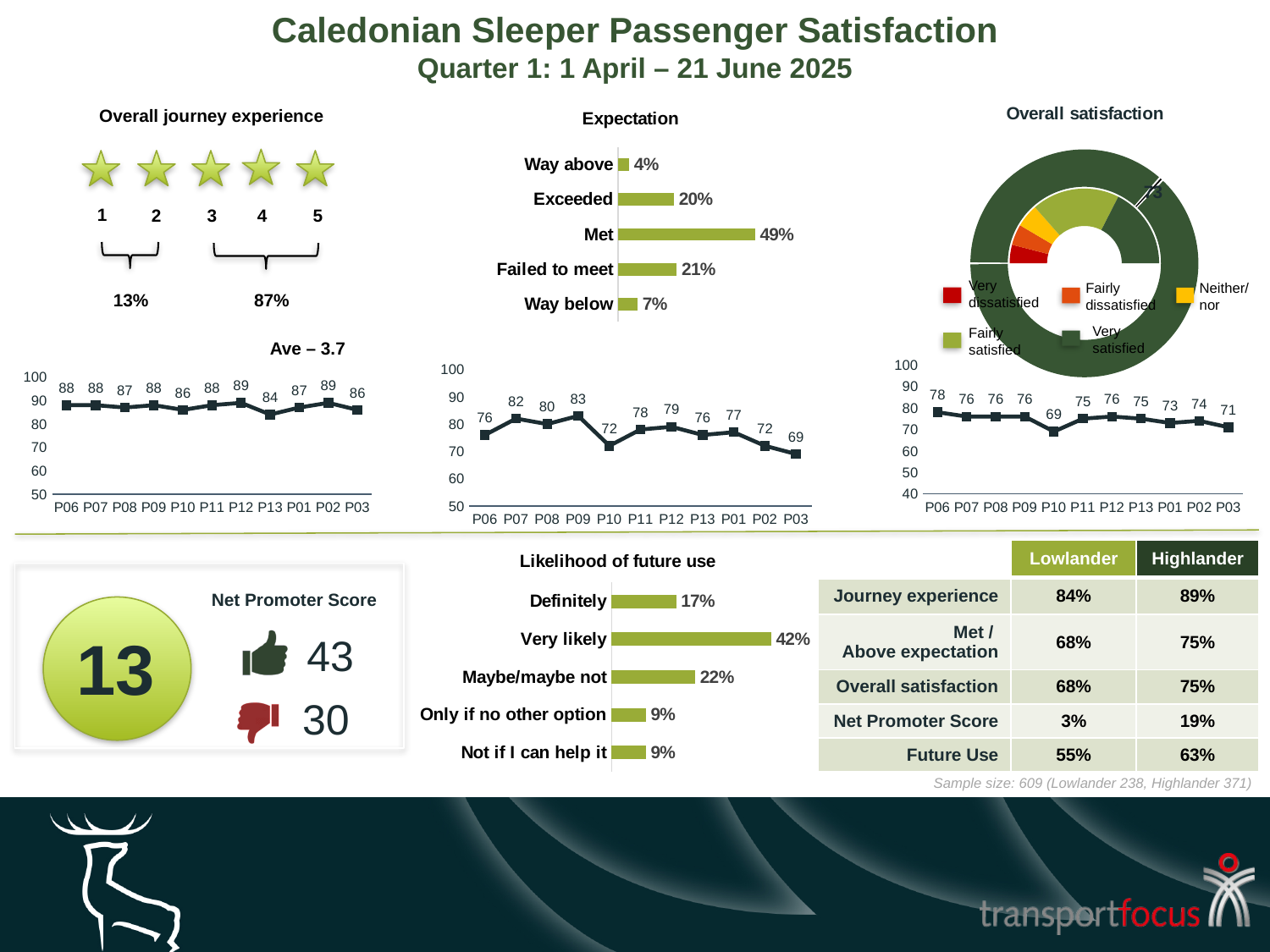
What kind of chart is used for the Likelihood of future use data? Bar chart In the Expectation bar chart, which category has the lowest percentage? Way above In the Likelihood of future use chart, how many categories are shown? 5 In the Expectation bar chart, what is the difference between the Exceeded and Failed to meet percentages? 1% In the Expectation line chart, which is larger, the value for P07 or the value for P10? P07 In the Expectation bar chart, what percentage of passengers said their expectations were met? 49% In the Likelihood of future use chart, what percentage of passengers answered Very likely? 42% In the Overall journey experience line chart, which period has the lowest value? P13 In the Likelihood of future use chart, which category has the highest percentage? Very likely In the Expectation line chart, what is the value for P03? 69 In the Overall journey experience line chart, what is the value for P13? 84 In the Overall satisfaction line chart, what is the difference between the P06 value and the P03 value? 7